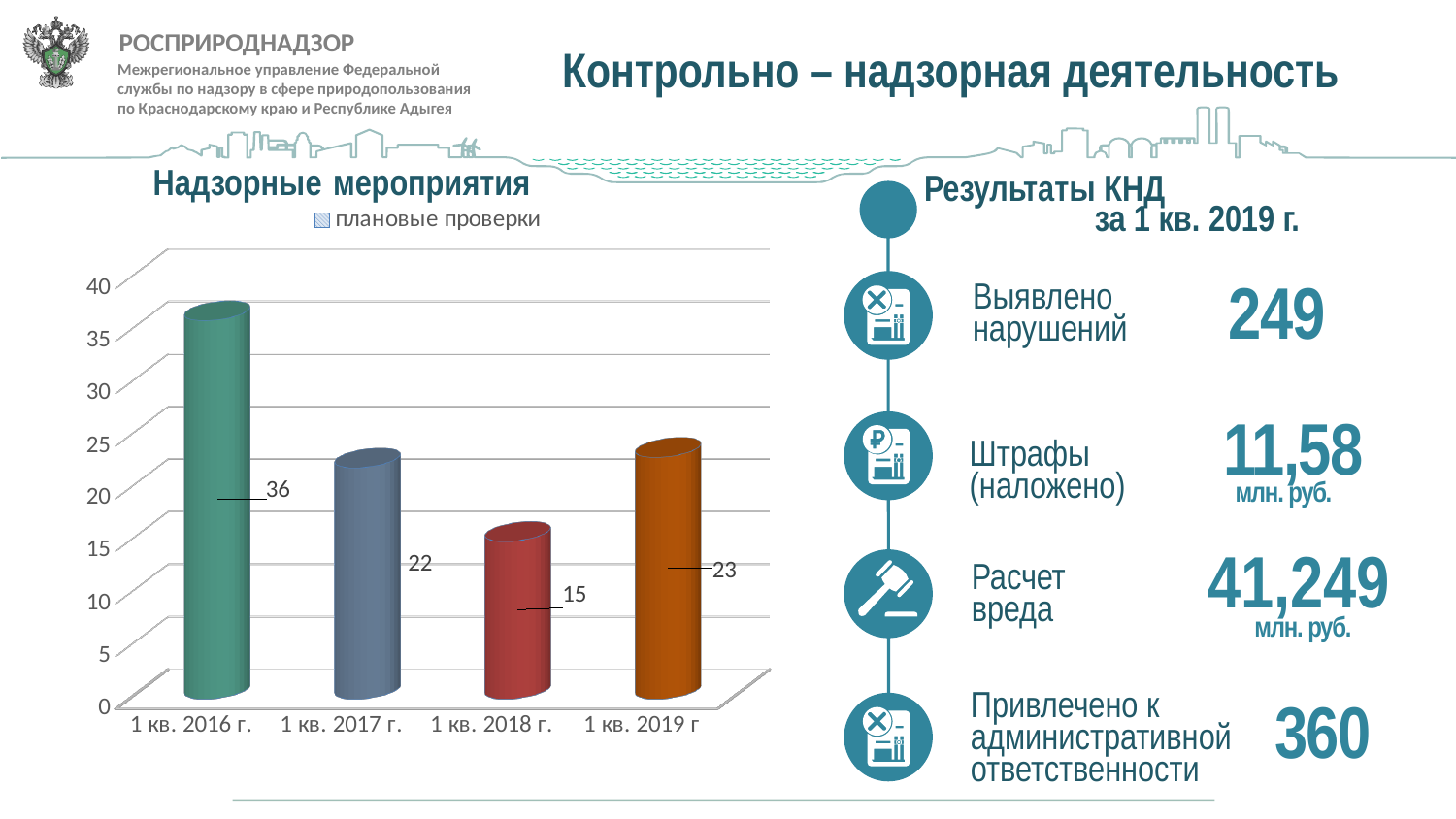
What is the difference between the values for 1 кв. 2016 г. and 1 кв. 2017 г.? 14 What is the value for 1 кв. 2018 г. in the chart? 15 What kind of chart is shown on the slide? bar chart What is the difference between the values for 1 кв. 2019 г and 1 кв. 2018 г.? 8 How many series does the chart legend list? 1 What is the value for 1 кв. 2019 г in the chart? 23 How many categories are shown on the x axis of the chart? 4 What is the value for 1 кв. 2016 г. in the chart? 36 Which category has the lowest value in the chart? 1 кв. 2018 г. What series name is shown in the chart legend? плановые проверки Which is larger: the value for 1 кв. 2017 г. or the value for 1 кв. 2019 г? 1 кв. 2019 г Which category has the highest value in the chart? 1 кв. 2016 г.